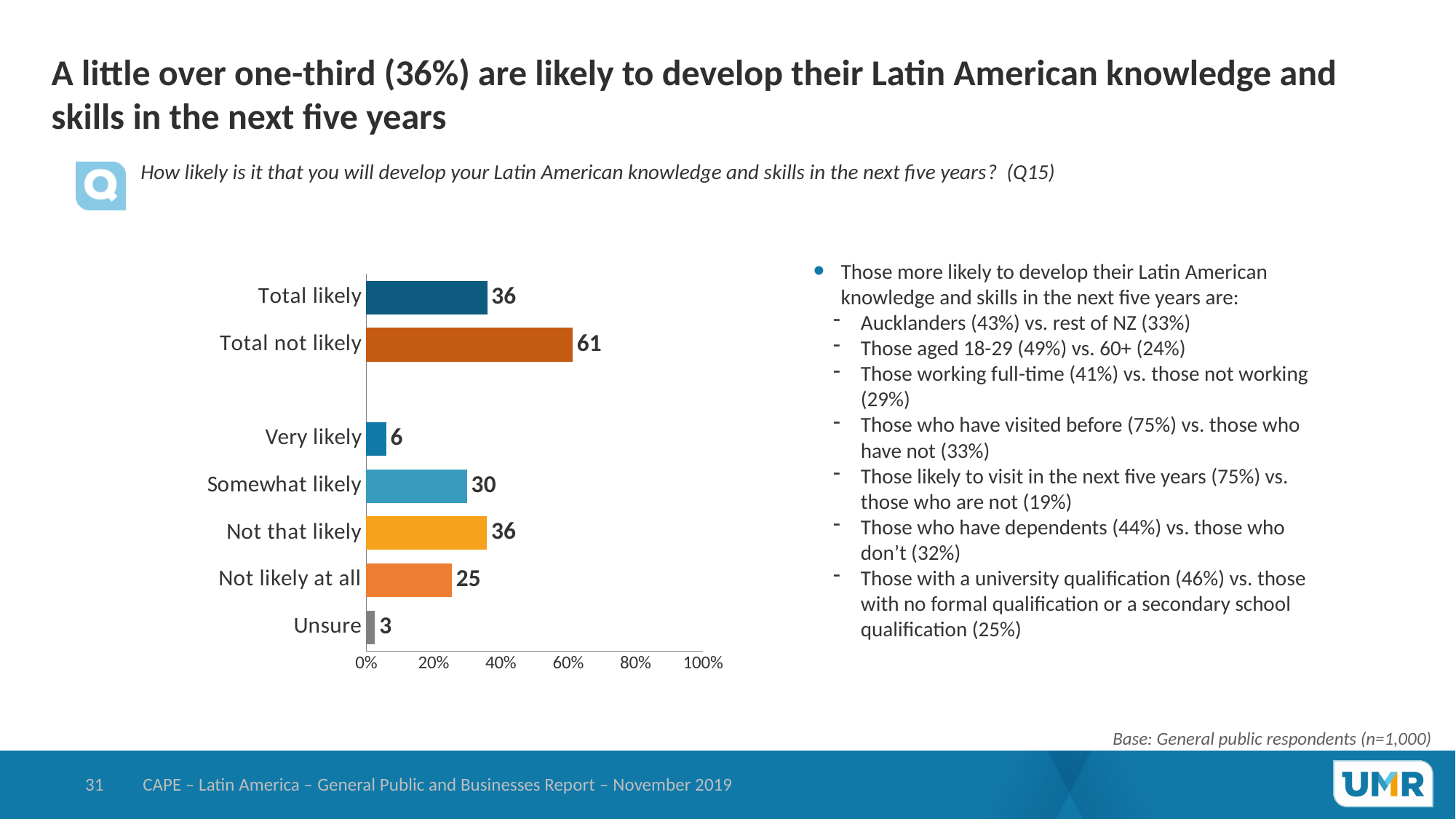
Is the value for Total not likely greater or less than 40%? greater Which category has the highest value? Total not likely What is the value for Very likely? 6 What is the value for Somewhat likely? 30 What kind of chart is shown on the slide? Bar chart What is the difference between Total not likely and Total likely? 25 What is the value for Unsure? 3 Which is larger, Not that likely or Not likely at all? Not that likely How many categories are shown on the chart? 7 What is the value for Total not likely? 61 Which category has the lowest value? Unsure What is the value for Total likely? 36